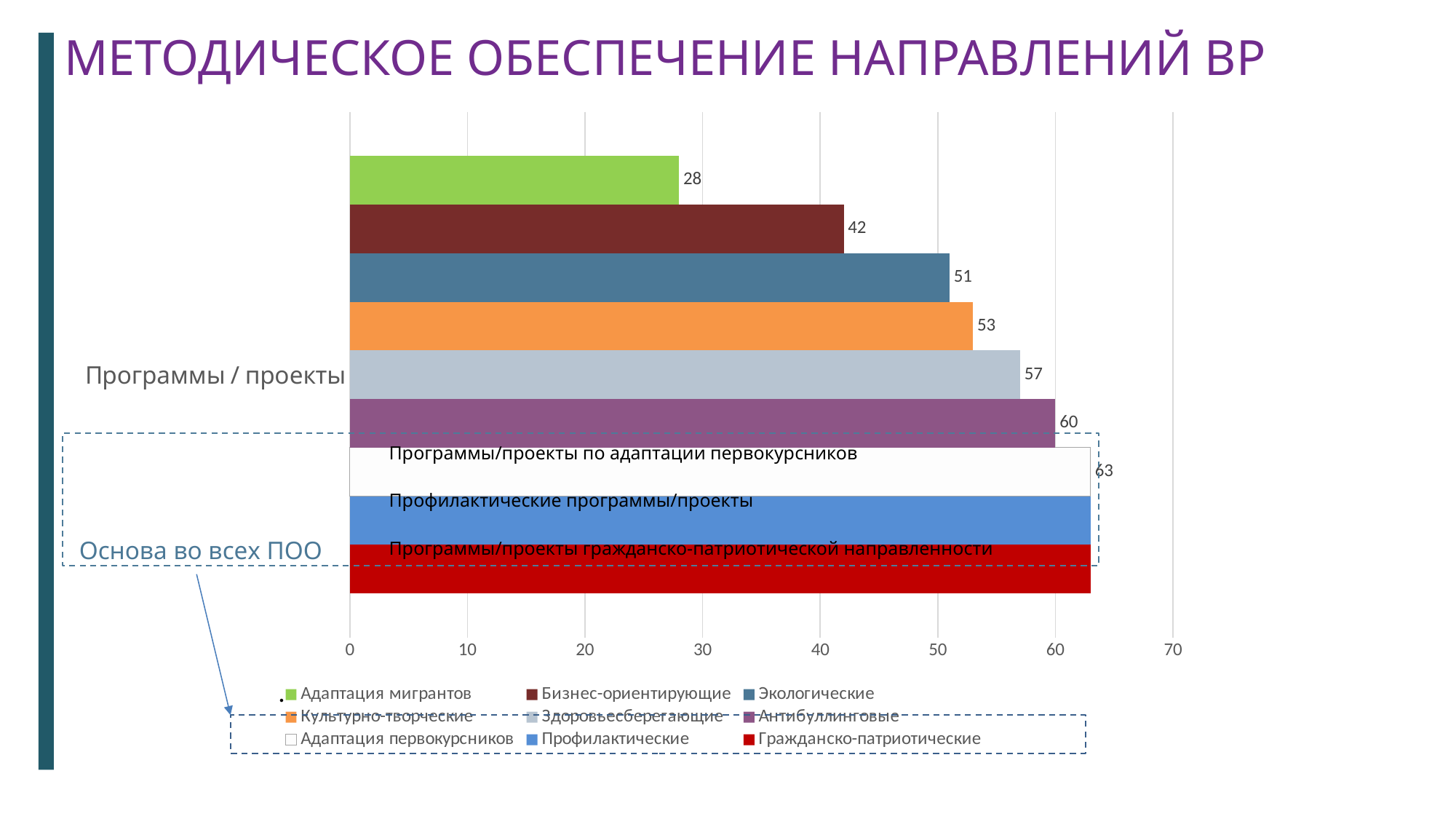
What is the difference between the values for Культурно-творческие and Бизнес-ориентирующие? 11 What is the value for Здоровьесберегающие? 57 What is the value for Бизнес-ориентирующие? 42 Which is larger, the value for Здоровьесберегающие or the value for Экологические? Здоровьесберегающие What is the value for Адаптация мигрантов? 28 What is the value for Антибуллинговые? 60 What is the value for Экологические? 51 What is the title of the slide? МЕТОДИЧЕСКОЕ ОБЕСПЕЧЕНИЕ НАПРАВЛЕНИЙ ВР Which series has the lowest value? Адаптация мигрантов What type of chart is shown on the slide? bar chart How many series does the legend list? 9 Is the value for Профилактические greater or less than 60? greater